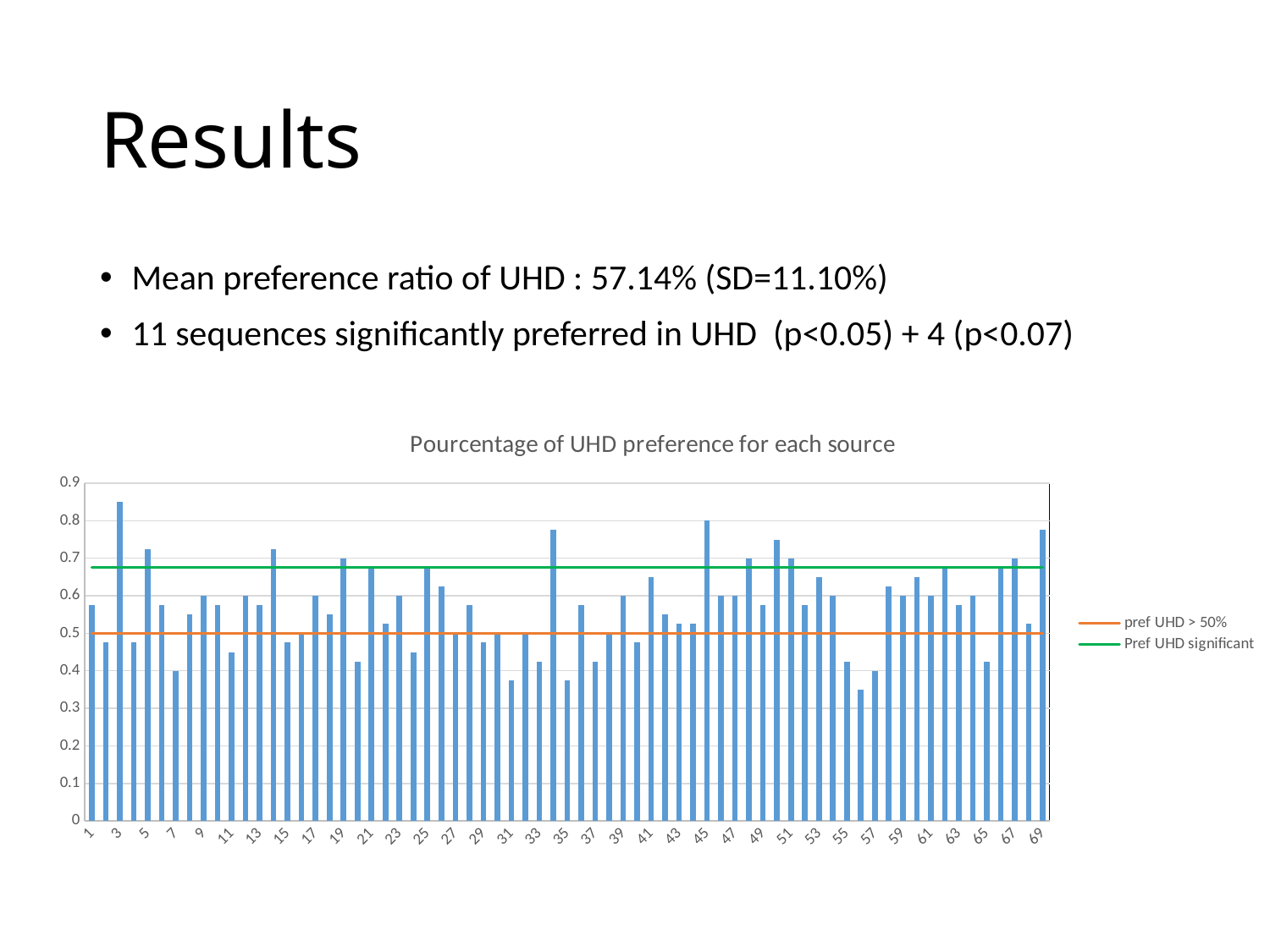
Is the value for source 34 greater or less than 0.7? greater What kind of chart is shown on the slide? bar chart Which has the larger value, source 34 or source 35? 34 Is the value for source 56 greater or less than 0.4? less What is the title of the chart? Pourcentage of UHD preference for each source How many entries does the chart legend list? 2 How many sources are plotted along the x axis? 69 Which source has the highest UHD preference bar? 3 Is the value for source 69 greater or less than 0.7? greater What are the two legend entries of the chart? pref UHD > 50% and Pref UHD significant